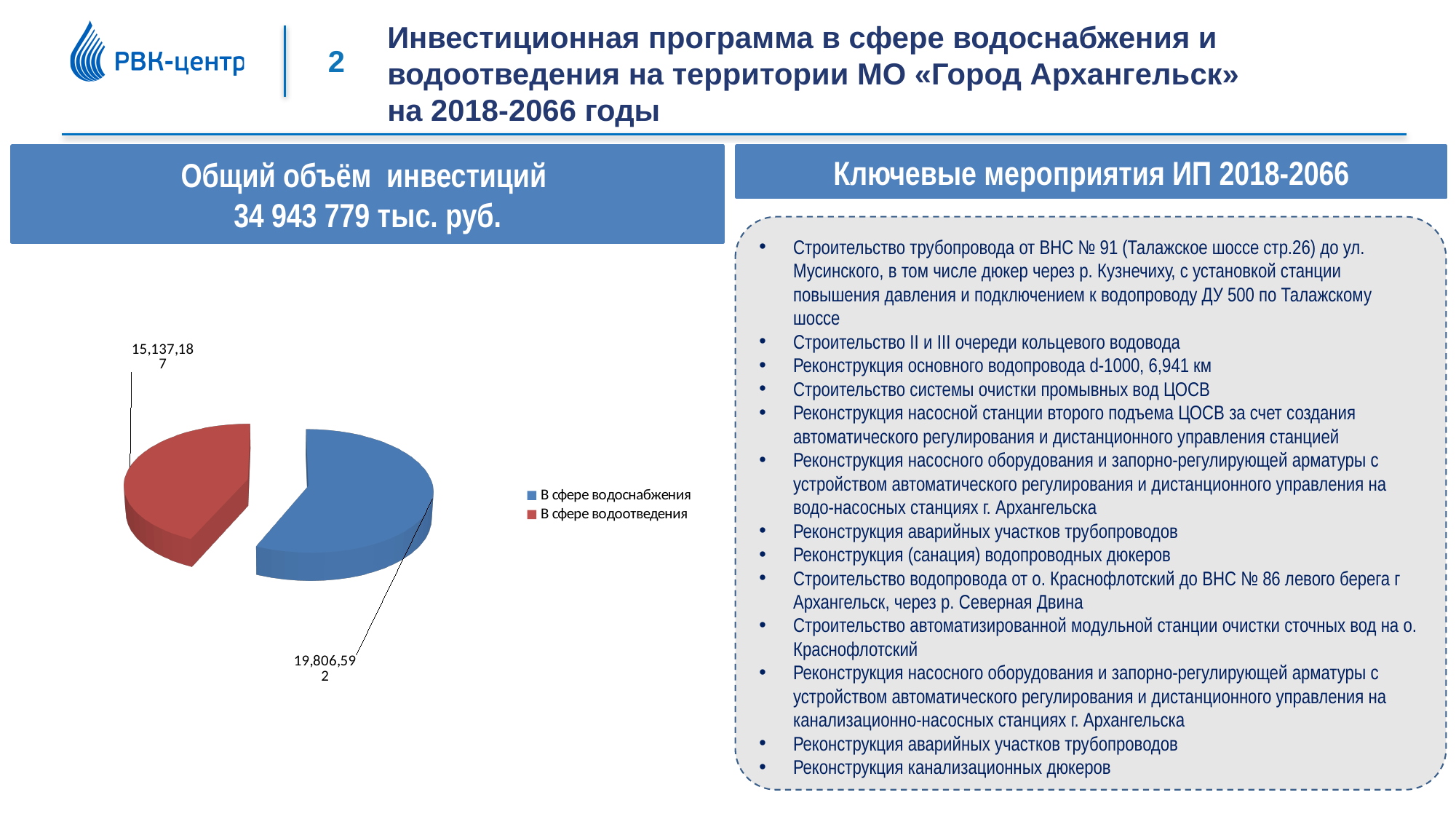
What is the value for «В сфере водоснабжения» in the pie chart? 19,806,592 Which category has the smallest slice in the pie chart? В сфере водоотведения Which category has the largest slice in the pie chart? В сфере водоснабжения What colour is the «В сфере водоотведения» slice in the pie chart? Red What type of chart is shown on the slide? Pie chart Which is larger: the value for «В сфере водоснабжения» or «В сфере водоотведения»? В сфере водоснабжения How many entries does the legend of the pie chart list? 2 What is the difference between the values for «В сфере водоснабжения» and «В сфере водоотведения»? 4,669,405 What is the total of the two slices in the pie chart? 34,943,779 What total investment volume is stated in the header above the pie chart? 34 943 779 тыс. руб. What is the value for «В сфере водоотведения» in the pie chart? 15,137,187 How many slices does the pie chart have? 2